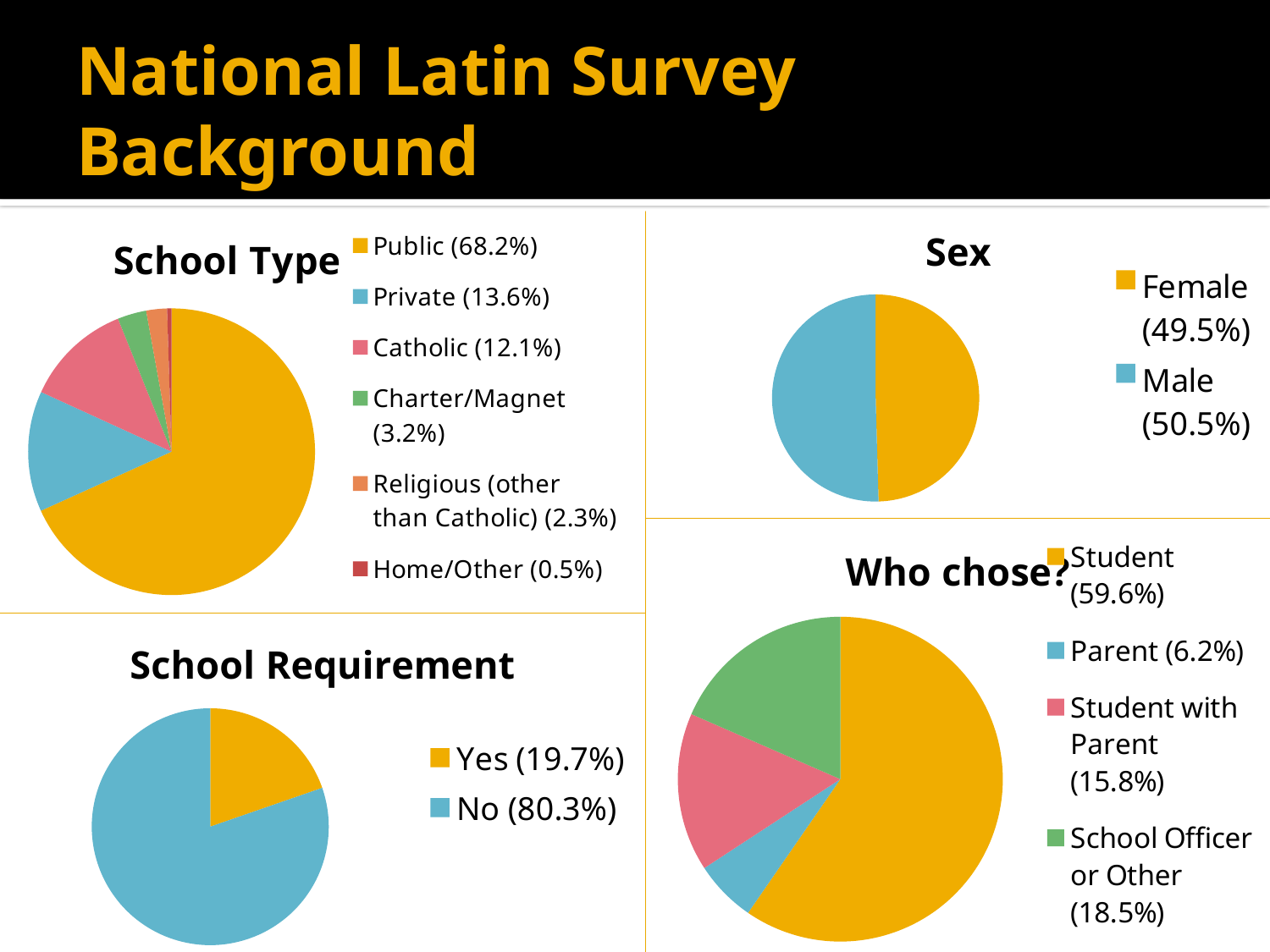
In the Sex chart, what share of respondents are Male? 50.5% In the Who chose? chart, which category has the largest share? Student In the School Requirement chart, what share answered No? 80.3% In the Sex chart, which category has the larger share, Female or Male? Male In the School Type chart, how many categories does the legend list? 6 In the Who chose? chart, which is larger, Parent or School Officer or Other? School Officer or Other In the School Type chart, which school type has the smallest share? Home/Other In the Who chose? chart, what share is Student with Parent? 15.8% In the School Requirement chart, what is the difference between the No and Yes shares? 60.6% What kind of chart is the School Requirement chart? Pie chart In the School Type chart, what is the difference between the Private and Catholic shares? 1.5%